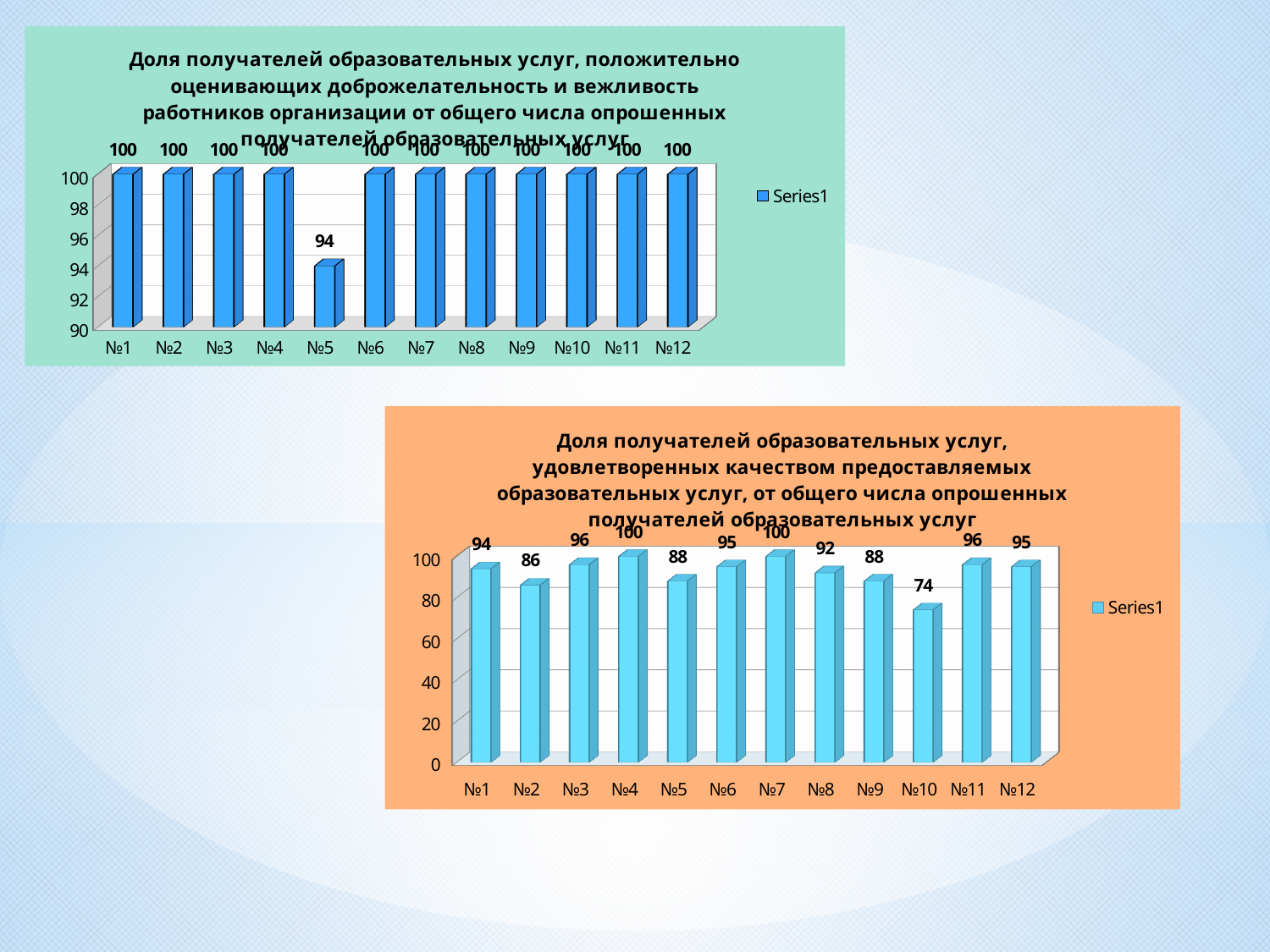
In the bottom chart, what is the value for №2? 86 What kind of chart is the bottom chart? bar chart How many series does the legend of the bottom chart list? 1 In the bottom chart, is the value for №10 greater or less than 80? less In the bottom chart, which category has the lowest value? №10 In the top chart, how many categories are shown on the x axis? 12 In the bottom chart, what is the difference between the values for №4 and №10? 26 In the top chart, what is the value for №5? 94 In the top chart, what is the difference between the values for №1 and №5? 6 In the top chart, which category has the lowest value? №5 In the bottom chart, which is larger, the value for №3 or the value for №8? №3 In the bottom chart, what is the value for №10? 74